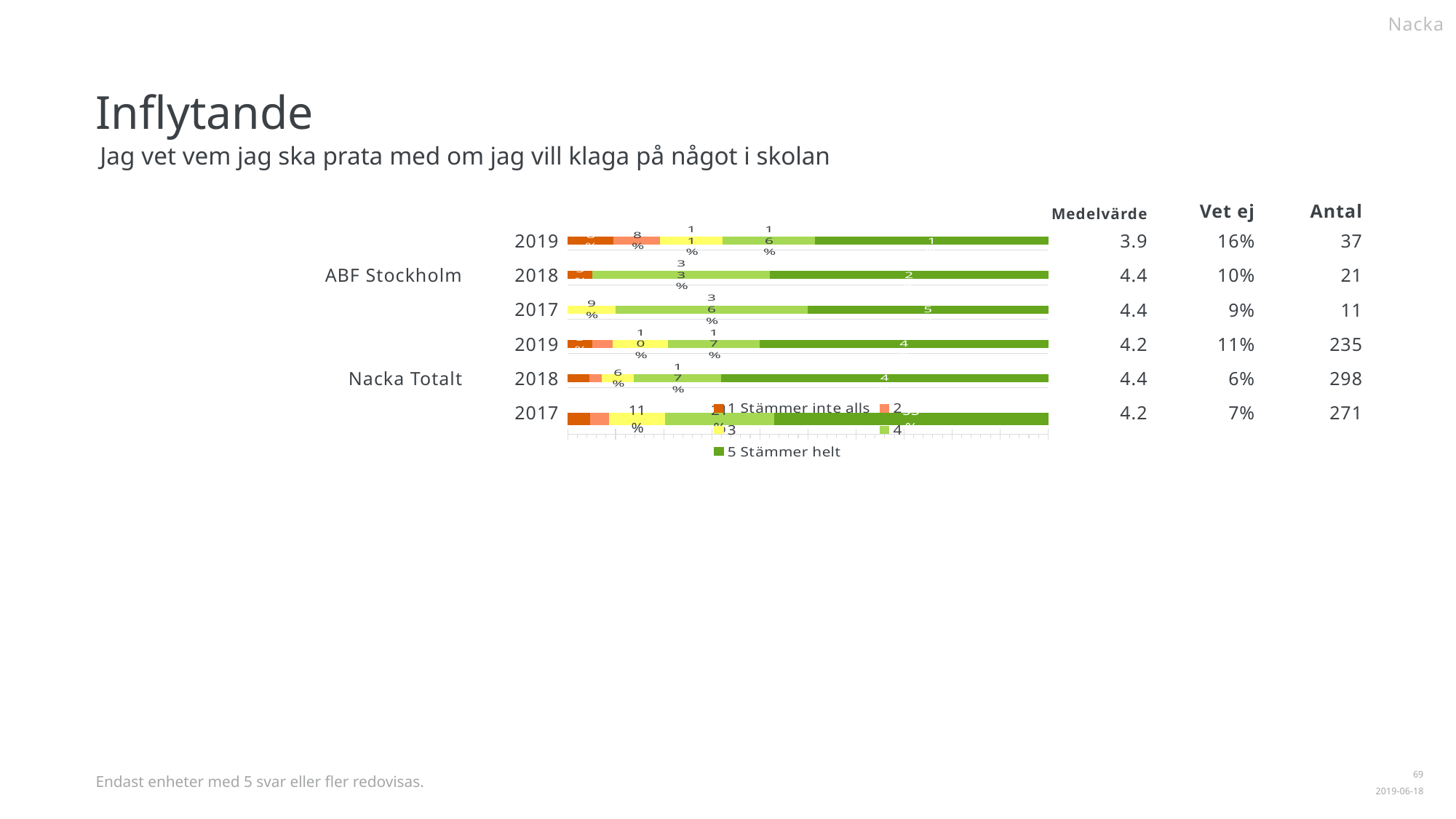
What is the difference between the series 3 values for Nacka Totalt 2019 and Nacka Totalt 2018? 4 percentage points What kind of chart is shown on the slide? Stacked bar chart How many bars are plotted in the chart? 6 How many series does the chart legend list? 5 What is the value of series 4 for Nacka Totalt 2019? 17% Which is larger, the series 4 value for ABF Stockholm 2017 or for ABF Stockholm 2018? ABF Stockholm 2017 What is the value of series 2 for ABF Stockholm 2019? 8% What is the value of series 4 for ABF Stockholm 2018? 33% What is the label of the last legend entry in the chart? 5 Stämmer helt What is the value of series 3 for Nacka Totalt 2018? 6% What is the label of the first legend entry in the chart? 1 Stämmer inte alls What is the value of series 4 for ABF Stockholm 2017? 36%